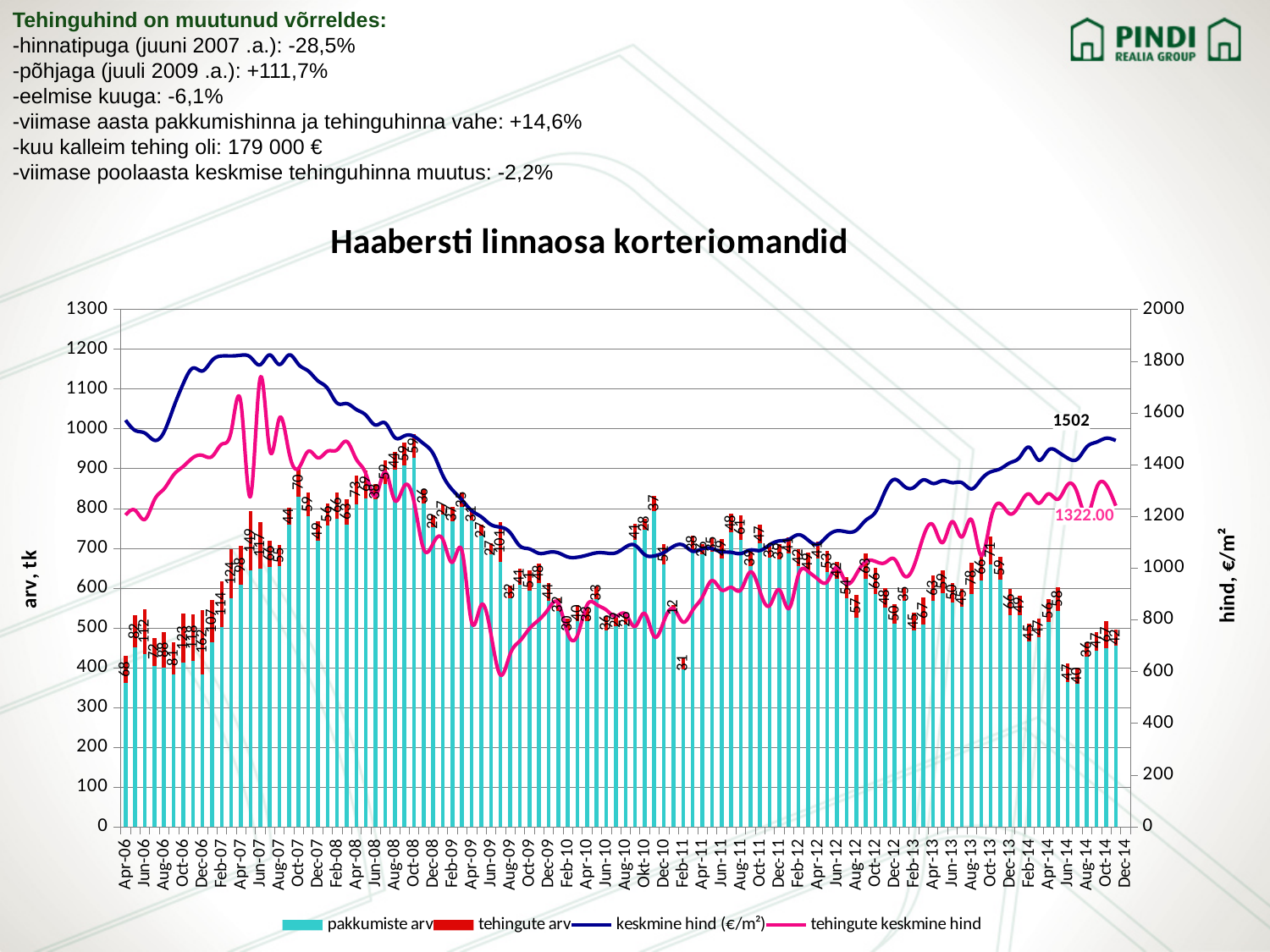
What is the difference between the labelled end values 1502 (keskmine hind) and 1322.00 (tehingute keskmine hind)? 180 Is the keskmine hind (€/m²) value in Apr-06 greater or less than 1400 on the right axis? greater What is the title of the chart? Haabersti linnaosa korteriomandid Does the keskmine hind (€/m²) line rise or fall between Jun-07 and Jun-09? fall What is the labelled value of the tehingute keskmine hind line at the end of the chart? 1322.00 Is the pakkumiste arv value in Jun-08 greater or less than 800 on the left axis? greater What is the labelled value of the keskmine hind (€/m²) line at the end of the chart? 1502 At the end of the chart, which is higher: keskmine hind (€/m²) or tehingute keskmine hind? keskmine hind (€/m²) In which year does the keskmine hind (€/m²) line reach its highest point? 2007 What kind of chart is shown on the slide? Combined bar and line chart What is the label of the right-hand vertical axis? hind, €/m² How many series does the chart legend list? 4